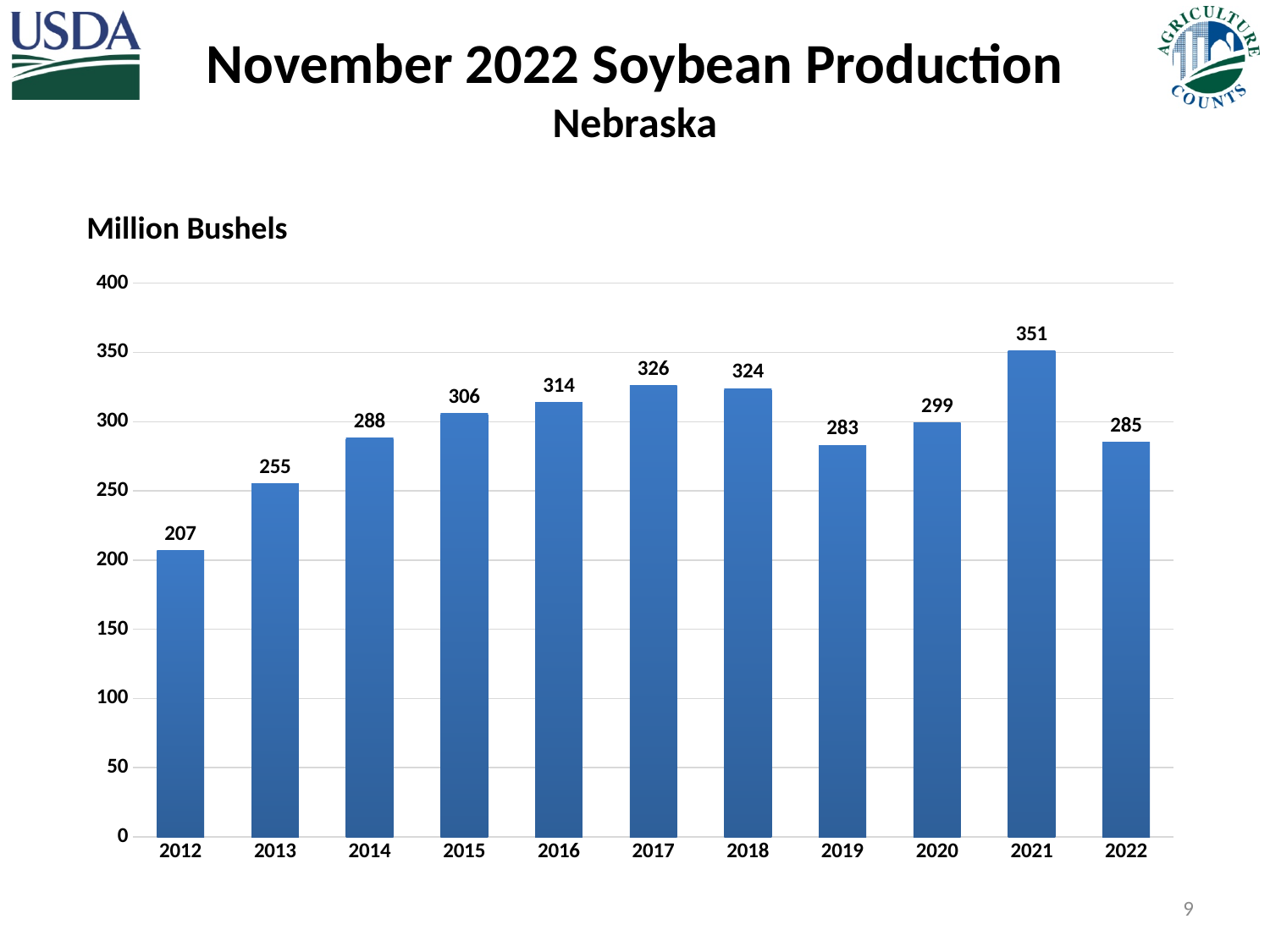
Which year had the lowest soybean production? 2012 What was Nebraska's soybean production in 2021? 351 What was Nebraska's soybean production in 2022? 285 What unit is the y axis measured in? Million Bushels How many years are shown on the chart? 11 What is the difference in production between 2017 and 2019? 43 How much did soybean production fall from 2021 to 2022? 66 Which year had the highest soybean production? 2021 Which year had higher production, 2016 or 2020? 2016 What was Nebraska's soybean production in 2012? 207 What kind of chart is shown on the slide? Bar chart Is the value for 2014 greater or less than 300? less